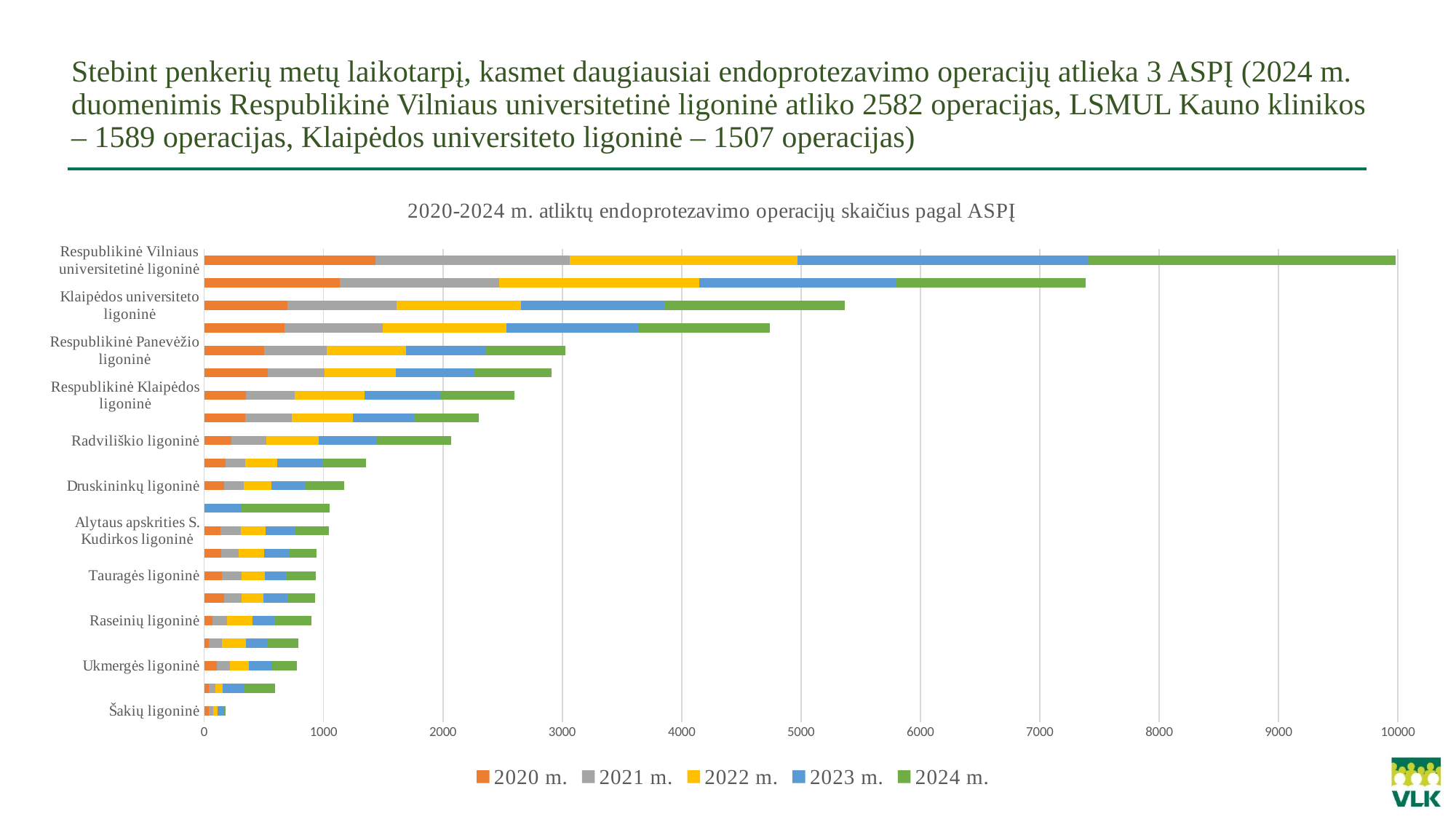
What kind of chart is shown on the slide? Stacked bar chart Is the total bar for Šakių ligoninė greater or less than 500? less Is the total bar for Klaipėdos universiteto ligoninė greater or less than 5000? greater How many series does the legend list? 5 Is the total bar for Tauragės ligoninė greater or less than 1000? less Which colour represents the 2024 m. series in the legend? Green What is the title of the chart? 2020-2024 m. atliktų endoprotezavimo operacijų skaičius pagal ASPĮ Which labelled hospital has the lowest total number of operations? Šakių ligoninė Which hospital has the highest total number of endoprosthesis operations over 2020-2024? Respublikinė Vilniaus universitetinė ligoninė Which has a larger total bar: Klaipėdos universiteto ligoninė or Respublikinė Panevėžio ligoninė? Klaipėdos universiteto ligoninė